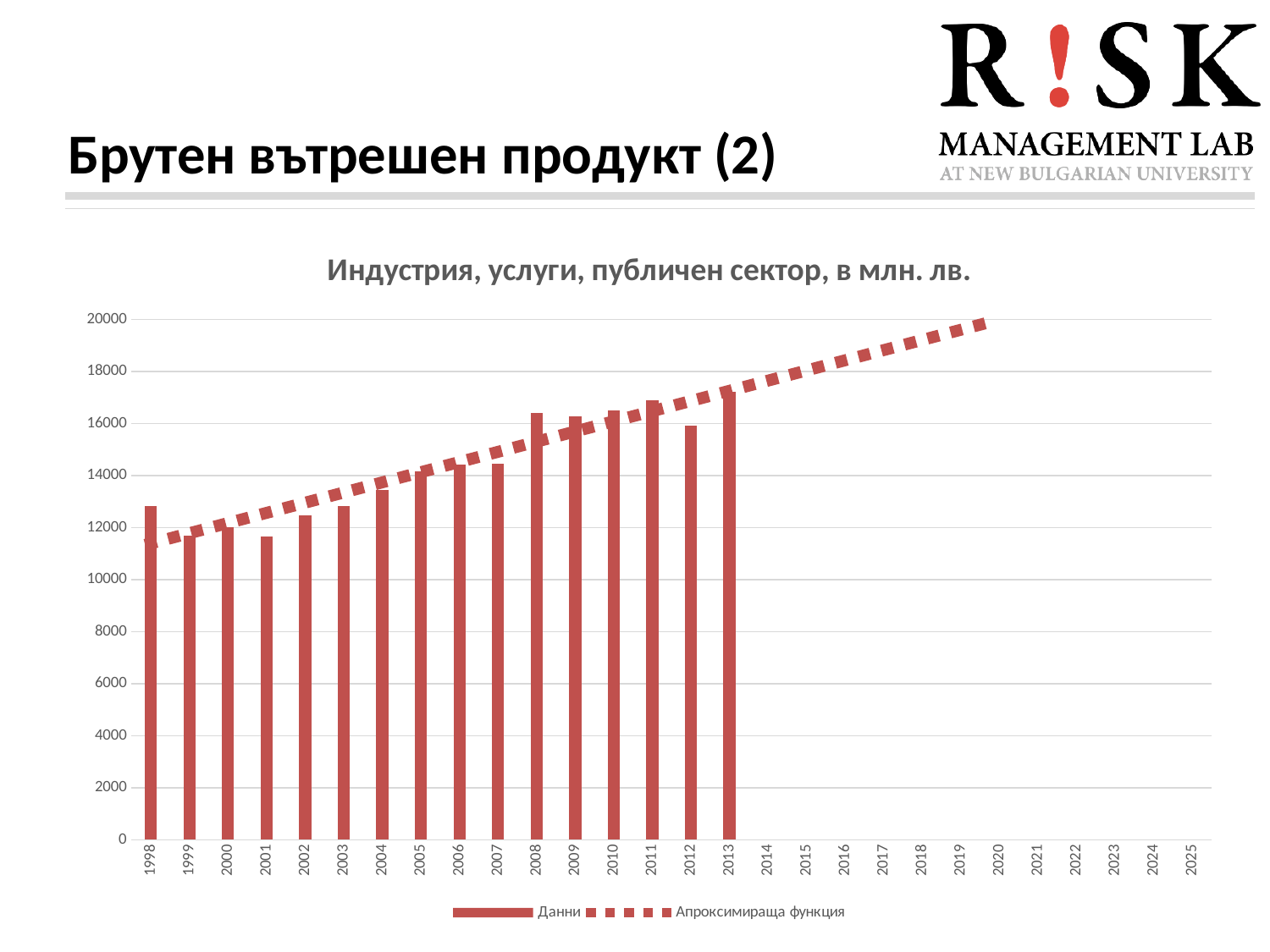
What is the title of the chart? Индустрия, услуги, публичен сектор, в млн. лв. Is the value for 2004 greater or less than 14000? less Do the bar values generally rise or fall from 1998 to 2013? rise Which year has the highest bar? 2013 What are the two entries in the legend? Данни and Апроксимираща функция Is the value for 2008 greater or less than 16000? greater What kind of chart is used to show the data series "Данни"? bar chart For how many years are bars plotted? 16 Is the value for 1998 greater or less than 12000? greater How many series does the legend list? 2 Which is larger, the bar for 2012 or the bar for 2013? 2013